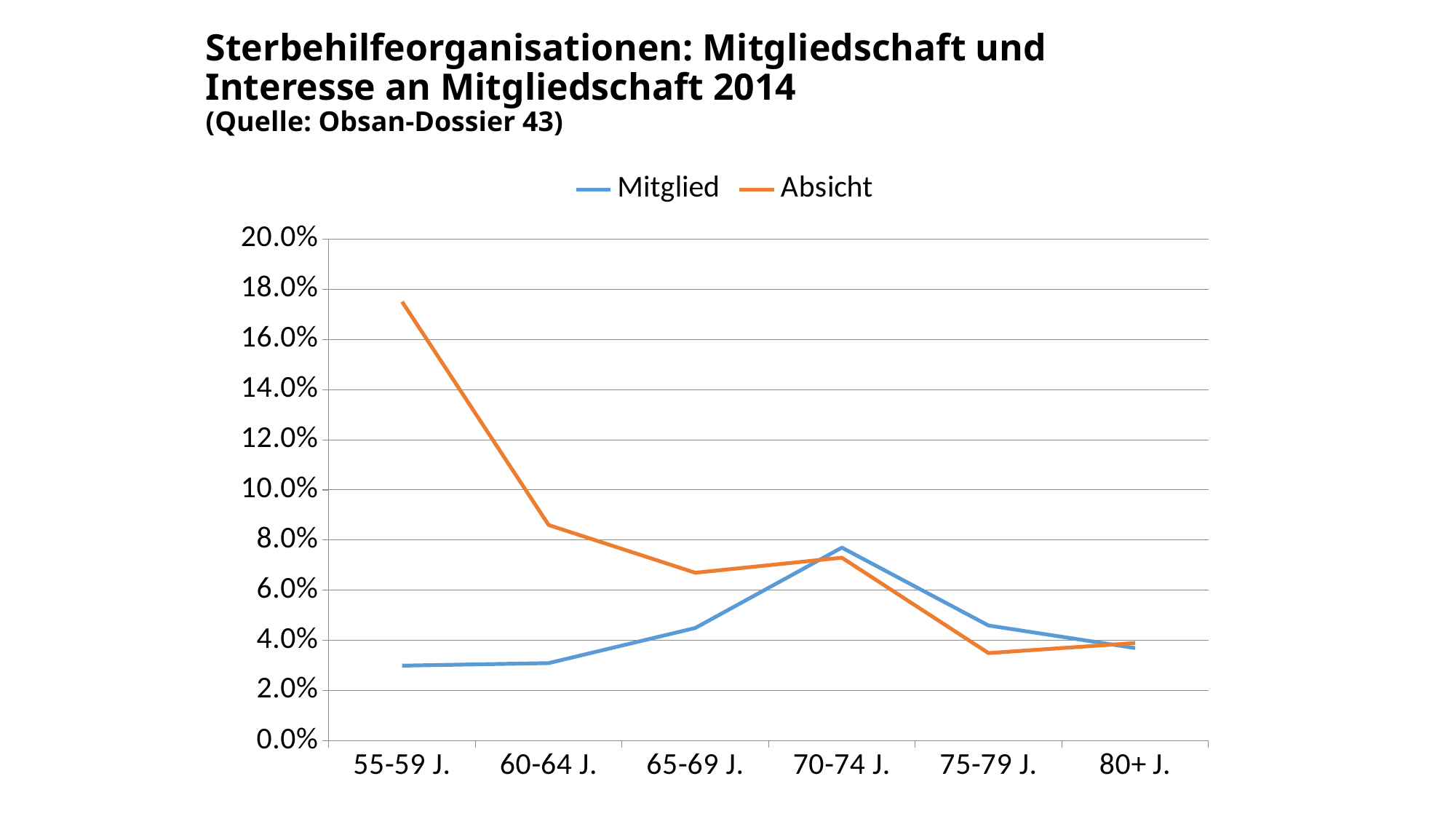
For which age group is the Absicht value lowest? 75-79 J. Is the Mitglied value for 55-59 J. greater or less than 4.0%? less At 60-64 J., which series has the larger value, Mitglied or Absicht? Absicht How many series does the legend list? 2 At 55-59 J., which series has the larger value, Mitglied or Absicht? Absicht For which age group is the Absicht value highest? 55-59 J. Which colour is used for the Mitglied series? blue How many age categories are shown on the x axis? 6 What kind of chart is shown on the slide? line chart Is the Absicht value for 55-59 J. greater or less than 16.0%? greater For which age group is the Mitglied value highest? 70-74 J. Does the Absicht line overall rise or fall from 55-59 J. to 80+ J.? fall